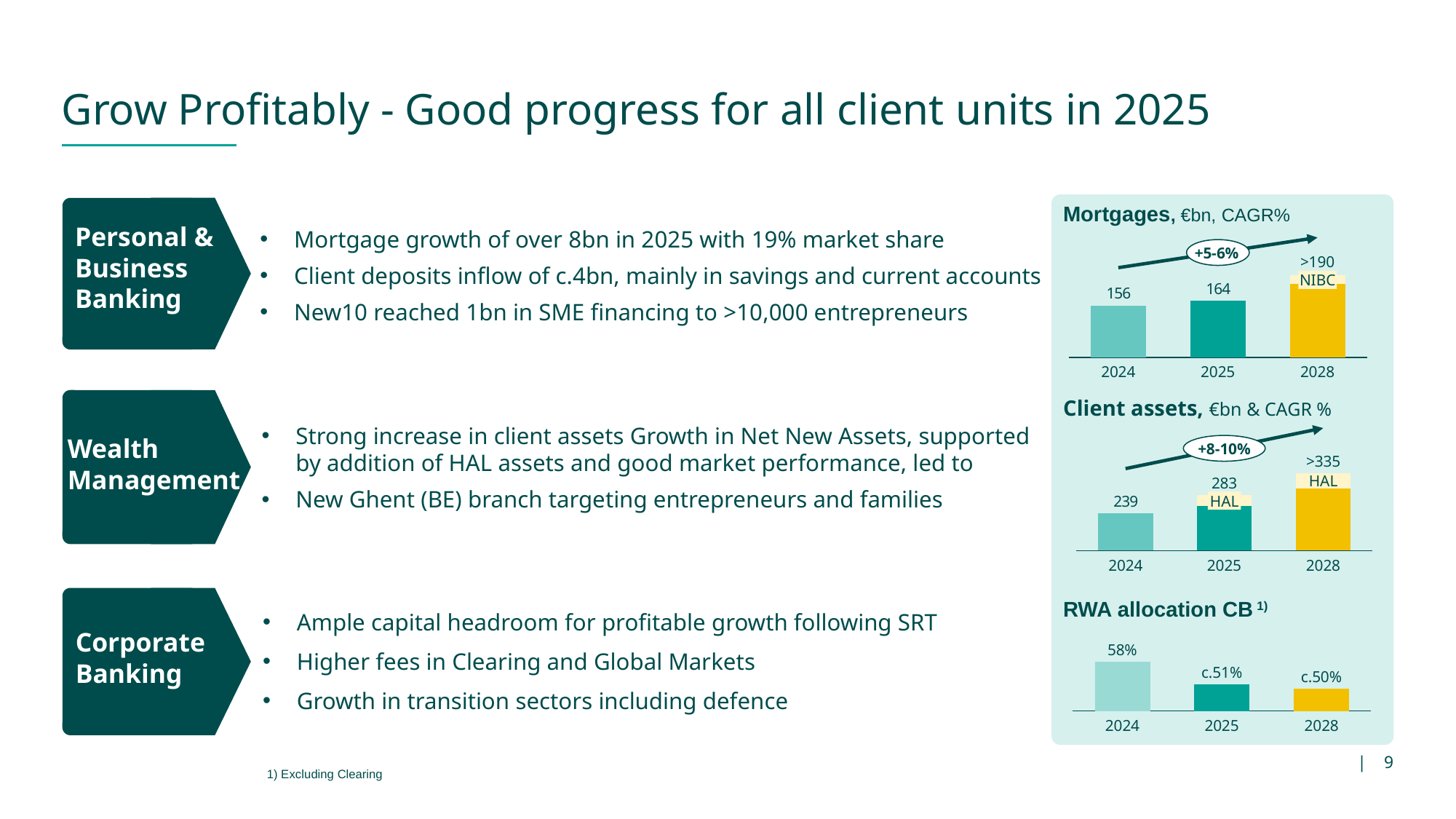
In the Client assets chart, which year has the highest value? 2028 In the Client assets chart, what is the value for 2024? 239 In the Mortgages chart, what is the difference between the 2025 and 2024 values? 8 In the Mortgages chart, what is the value shown for 2028? >190 What kind of chart is the Mortgages chart? bar chart In the RWA allocation CB chart, which year has the highest value? 2024 In the RWA allocation CB chart, what is the value for 2024? 58% In the Client assets chart, what is the value for 2025? 283 In the Client assets chart, what is the difference between the 2025 and 2024 values? 44 In the Mortgages chart, what is the value for 2024? 156 In the RWA allocation CB chart, do the values rise or fall from 2024 to 2028? fall In the Mortgages chart, what is the value for 2025? 164